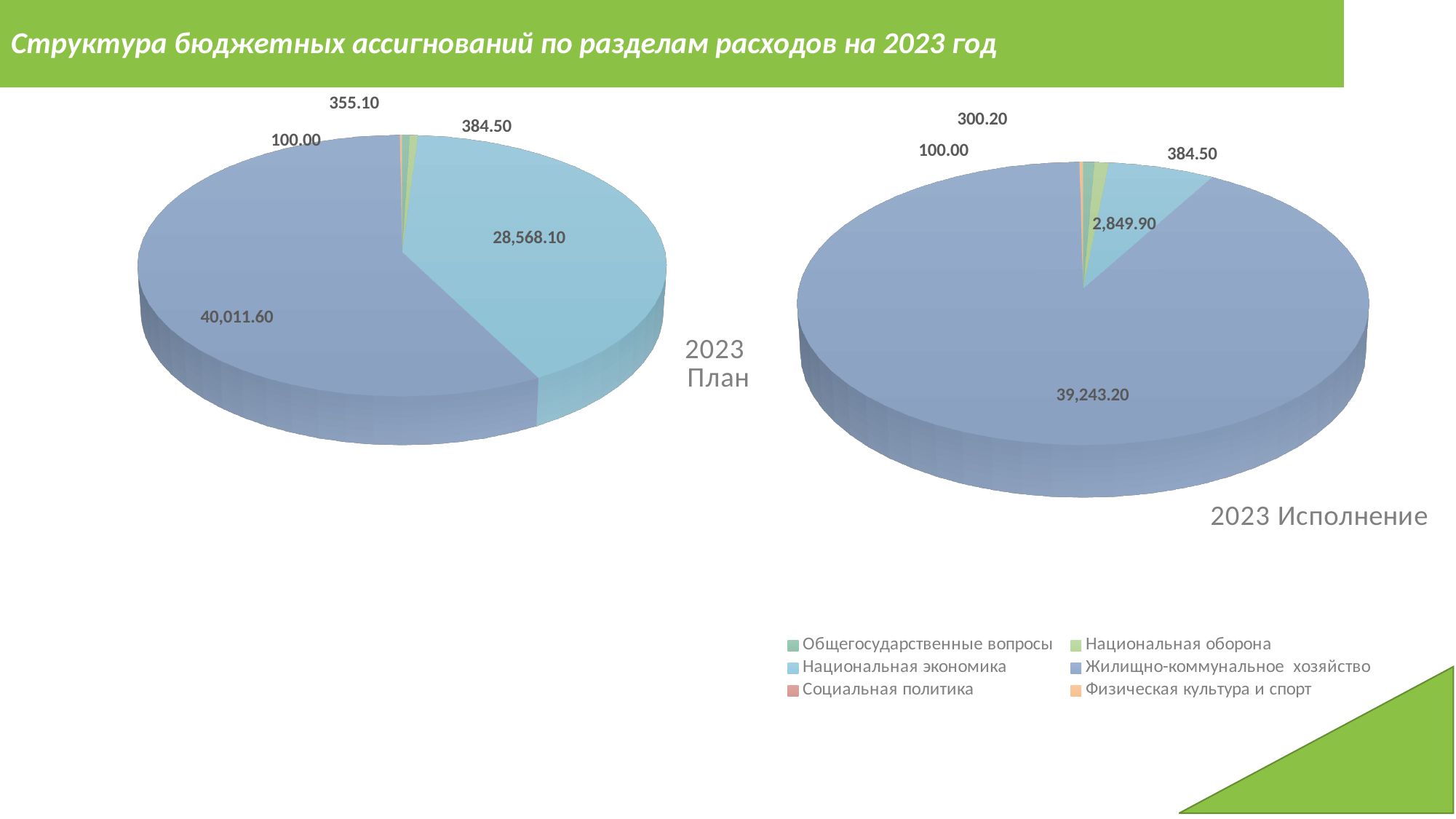
On the 2023 Исполнение chart, which category has the largest slice? Жилищно-коммунальное хозяйство What is the difference between the Национальная экономика value on the 2023 План chart and on the 2023 Исполнение chart? 25,718.20 How many categories does the legend list? 6 On the 2023 Исполнение chart, what is the value for Национальная экономика? 2,849.90 On the 2023 План chart, what is the value for Жилищно-коммунальное хозяйство? 40,011.60 On the 2023 План chart, which category has the largest slice? Жилищно-коммунальное хозяйство What is the difference between the Жилищно-коммунальное хозяйство value on the 2023 План chart and on the 2023 Исполнение chart? 768.40 On the 2023 Исполнение chart, what is the value for Жилищно-коммунальное хозяйство? 39,243.20 On the 2023 Исполнение chart, what is the value for Национальная оборона? 384.50 Is the value for Национальная экономика larger on the 2023 План chart or on the 2023 Исполнение chart? 2023 План What kind of chart is the 2023 План chart? Pie chart On the 2023 План chart, what is the value for Национальная экономика? 28,568.10